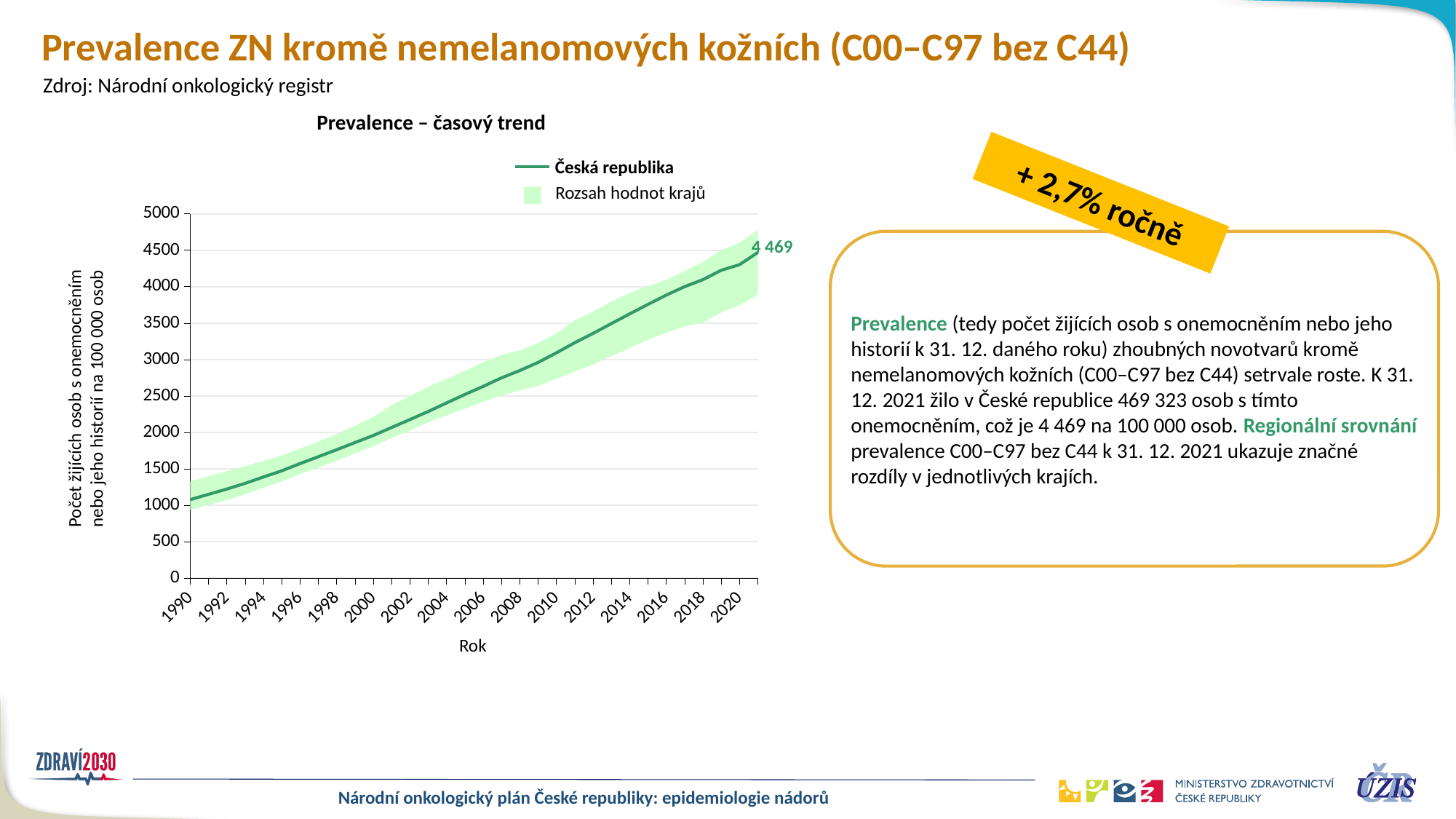
Does the Česká republika line rise or fall over the years shown on the x axis? rise Is the value for Česká republika in 2020 greater or less than 4000? greater Is the value for Česká republika in 1990 greater or less than 1500? less Is the value for Česká republika in 2000 greater or less than 1500? greater What is the value printed as a data label at the end of the Česká republika line? 4 469 What type of chart is shown on the slide? line chart How many year labels are shown on the x axis? 16 In which year on the x axis is the Česká republika value lowest? 1990 What does the light green shaded area represent according to the legend? Rozsah hodnot krajů What is the title of the chart? Prevalence – časový trend How many entries does the chart legend list? 2